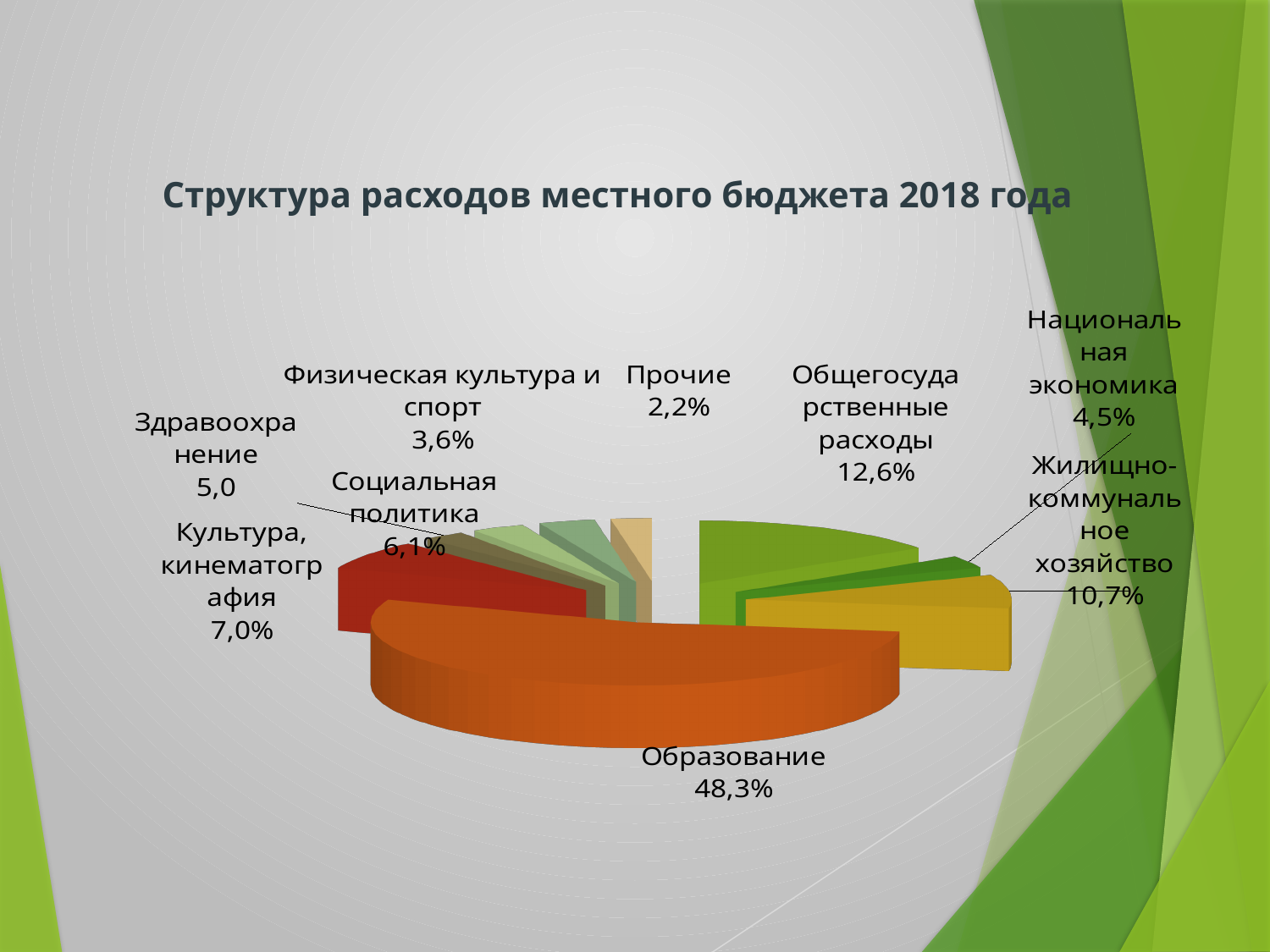
Какой тип диаграммы показан на слайде? Круговая диаграмма Какова доля категории «Социальная политика»? 6,1% Какова доля категории «Общегосударственные расходы»? 12,6% Какова доля категории «Национальная экономика»? 4,5% Какова доля категории «Образование» на диаграмме? 48,3% Сколько категорий показано на диаграмме? 9 Что больше: доля «Культура, кинематография» или доля «Социальная политика»? Культура, кинематография На сколько процентных пунктов доля «Общегосударственные расходы» больше доли «Жилищно-коммунальное хозяйство»? 1,9 Какая категория имеет наименьшую долю расходов? Прочие Какова доля категории «Жилищно-коммунальное хозяйство»? 10,7% Какая категория имеет наибольшую долю расходов? Образование Как называется диаграмма на слайде? Структура расходов местного бюджета 2018 года